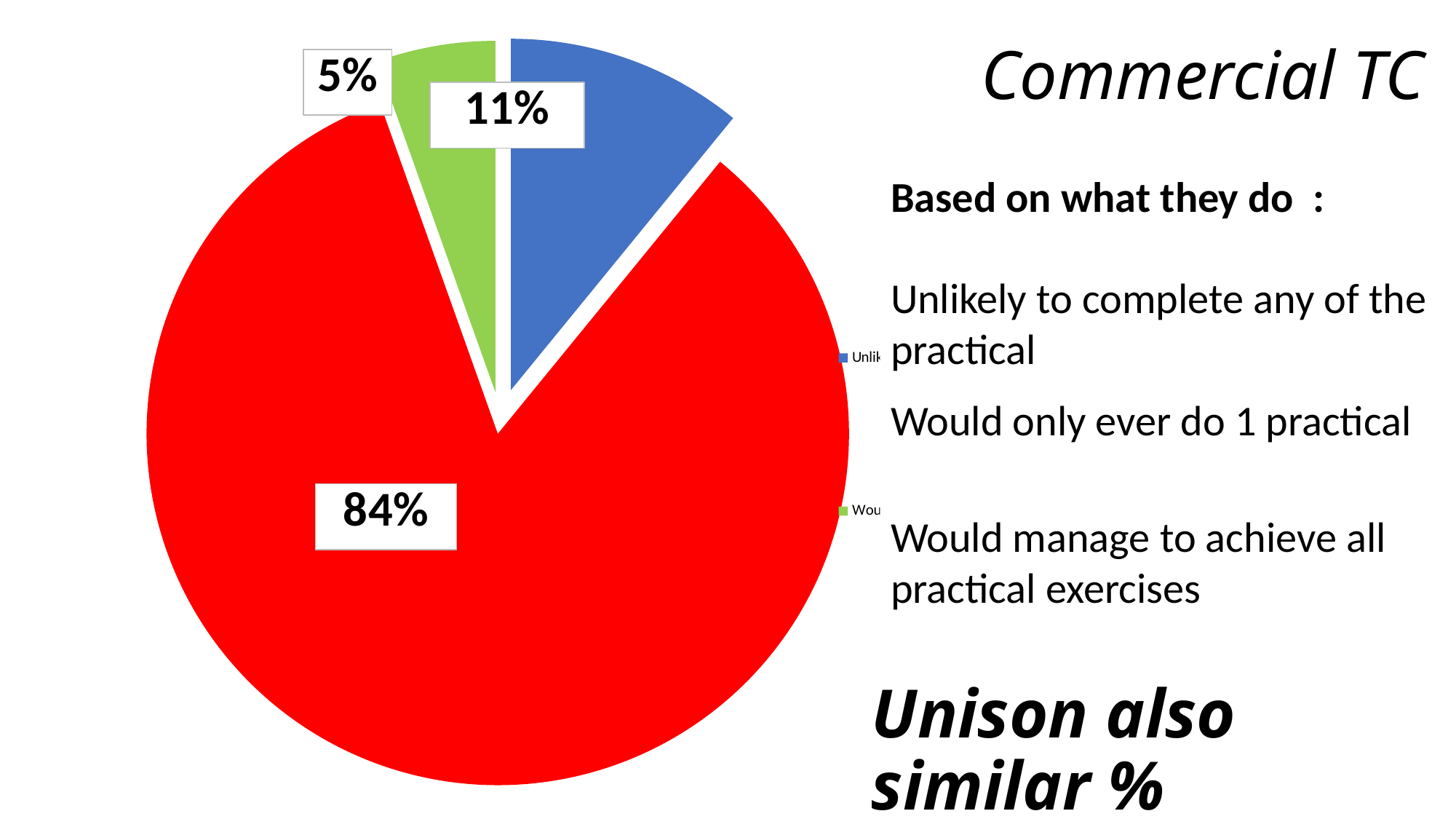
What percentage is shown on the green slice of the pie chart? 5% What percentage is shown on the blue slice of the pie chart? 11% Which slice of the pie chart is the smallest? the green slice (5%) What is the title shown at the top right of the slide? Commercial TC Is the value of the red slice greater or less than 50%? greater How many slices does the pie chart have? 3 What is the difference in percentage points between the red slice and the blue slice? 73 Which slice of the pie chart is the largest? the red slice (84%) Which slice colour does the legend entry beginning with 'Unlik' correspond to? blue What kind of chart is shown on the slide? pie chart Which is larger, the blue slice or the green slice? the blue slice What percentage is shown on the red slice of the pie chart? 84%